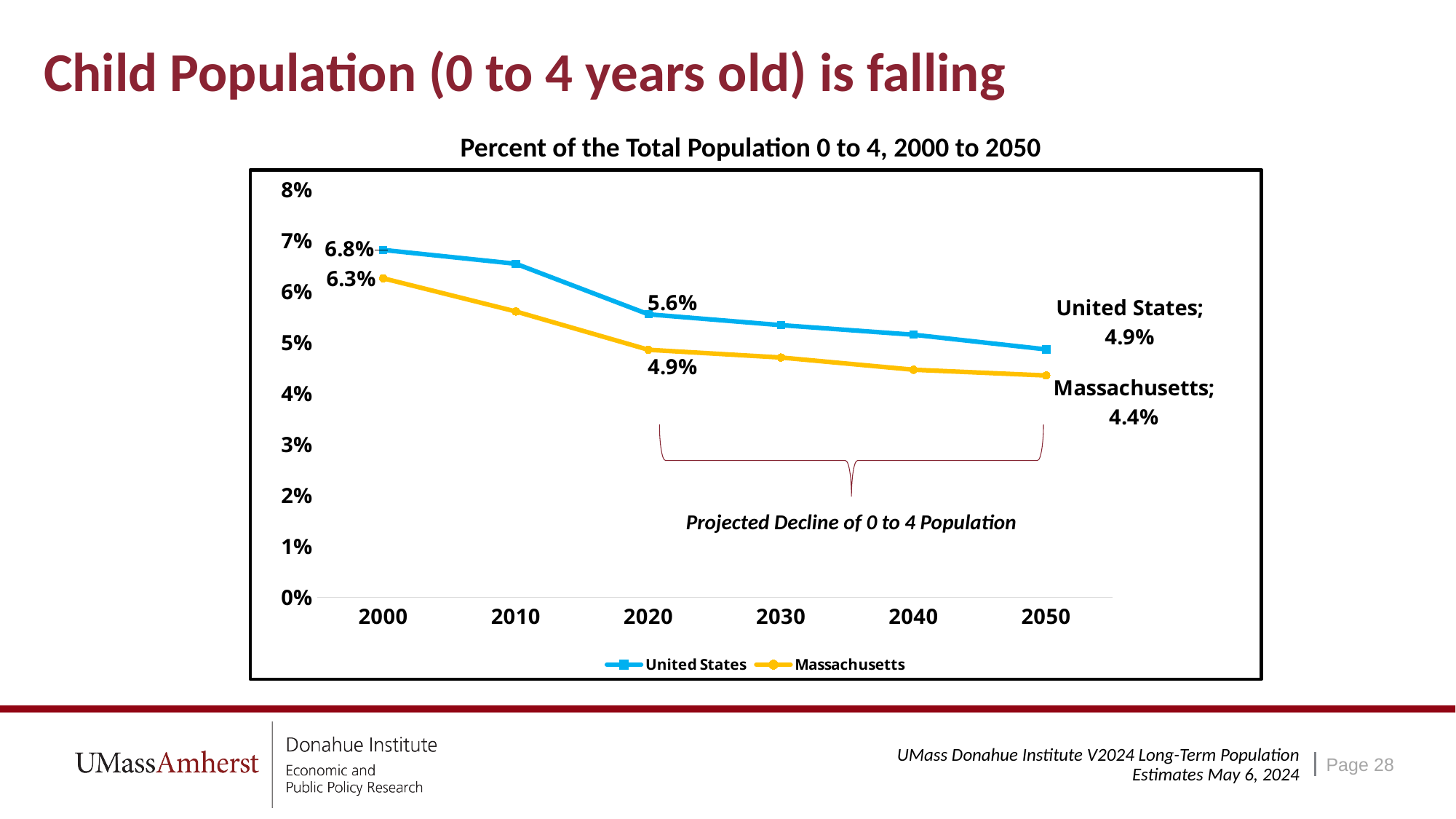
What kind of chart is shown? Line chart What is the difference between the United States values in 2000 and 2050? 1.9% What is the value for United States in 2020? 5.6% What is the difference between the United States and Massachusetts values in 2000? 0.5% Is the value for Massachusetts in 2010 greater or less than 5%? greater Do the values rise or fall from 2000 to 2050? Fall Which series is higher in 2020, United States or Massachusetts? United States What is the value for United States in 2000? 6.8% What is the value for Massachusetts in 2000? 6.3% What is the value for Massachusetts in 2050? 4.4% How many series does the legend list? 2 What is the value for United States in 2050? 4.9%